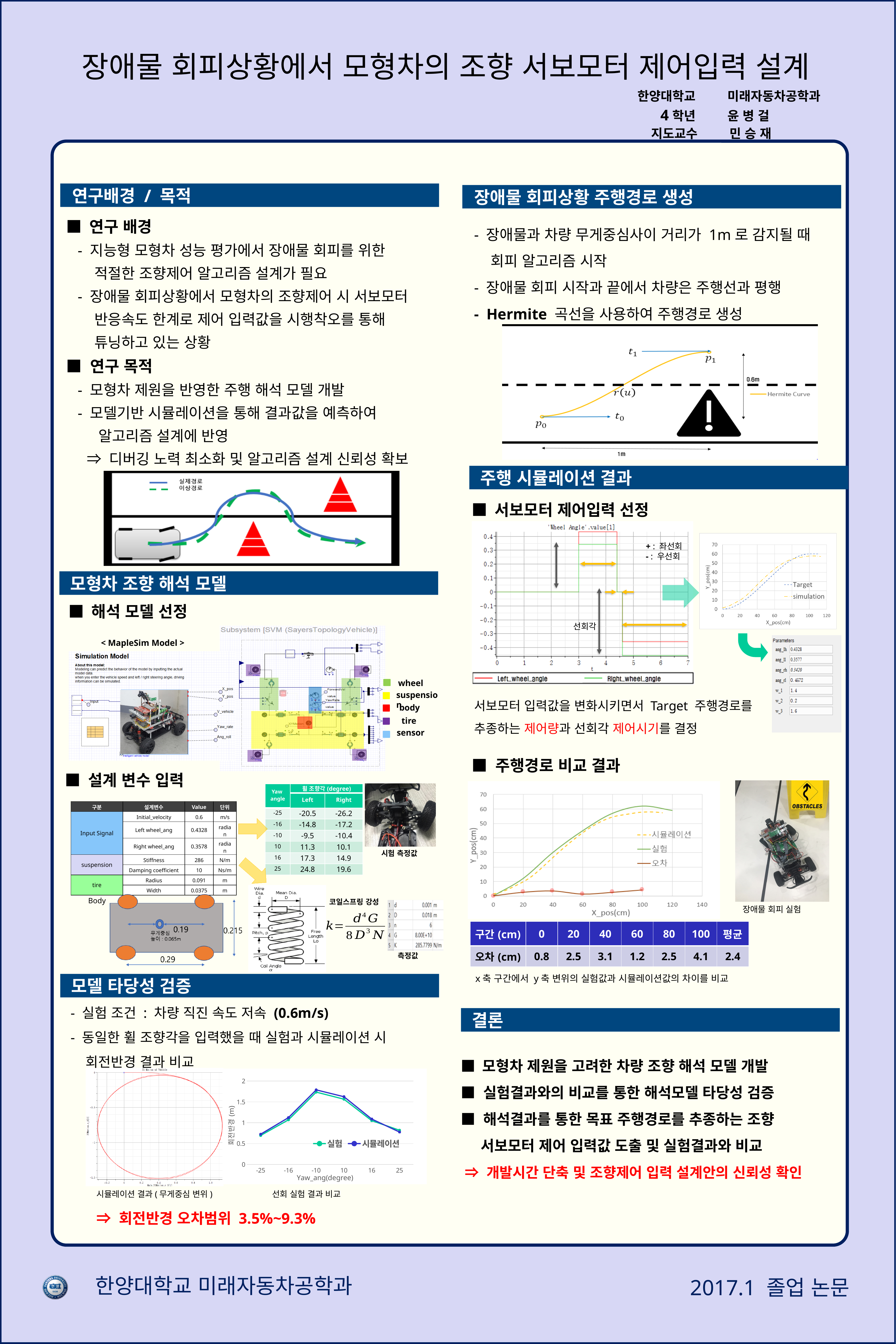
In the '선회 실험 결과 비교' chart, at which Yaw_ang(degree) value is the 회전반경 highest? -10 What kind of chart is the '선회 실험 결과 비교' chart at the bottom left? line chart How many series does the legend of the 'Wheel Angle.value[1]' chart list? 2 In the '주행경로 비교 결과' chart, is the 실험 Y_pos at X_pos 100 greater or less than 50? greater How many series does the legend of the '선회 실험 결과 비교' chart list? 2 In the '선회 실험 결과 비교' chart, is the 회전반경 at Yaw_ang -25 greater or less than 1? less In the '주행경로 비교 결과' chart, which series stays lowest across the whole x axis? 오차 How many Yaw_ang(degree) tick points are plotted along the x axis of the '선회 실험 결과 비교' chart? 6 How many series does the legend of the '주행경로 비교 결과' chart list? 3 In the '선회 실험 결과 비교' chart, is the 회전반경 at Yaw_ang -10 greater or less than 1.5? greater In the error table under the '주행경로 비교 결과' chart, what is the difference between the 오차 at 40 cm and at 60 cm? 1.9 In the error table under the '주행경로 비교 결과' chart, what is the 오차 (cm) at 구간 100 cm? 4.1